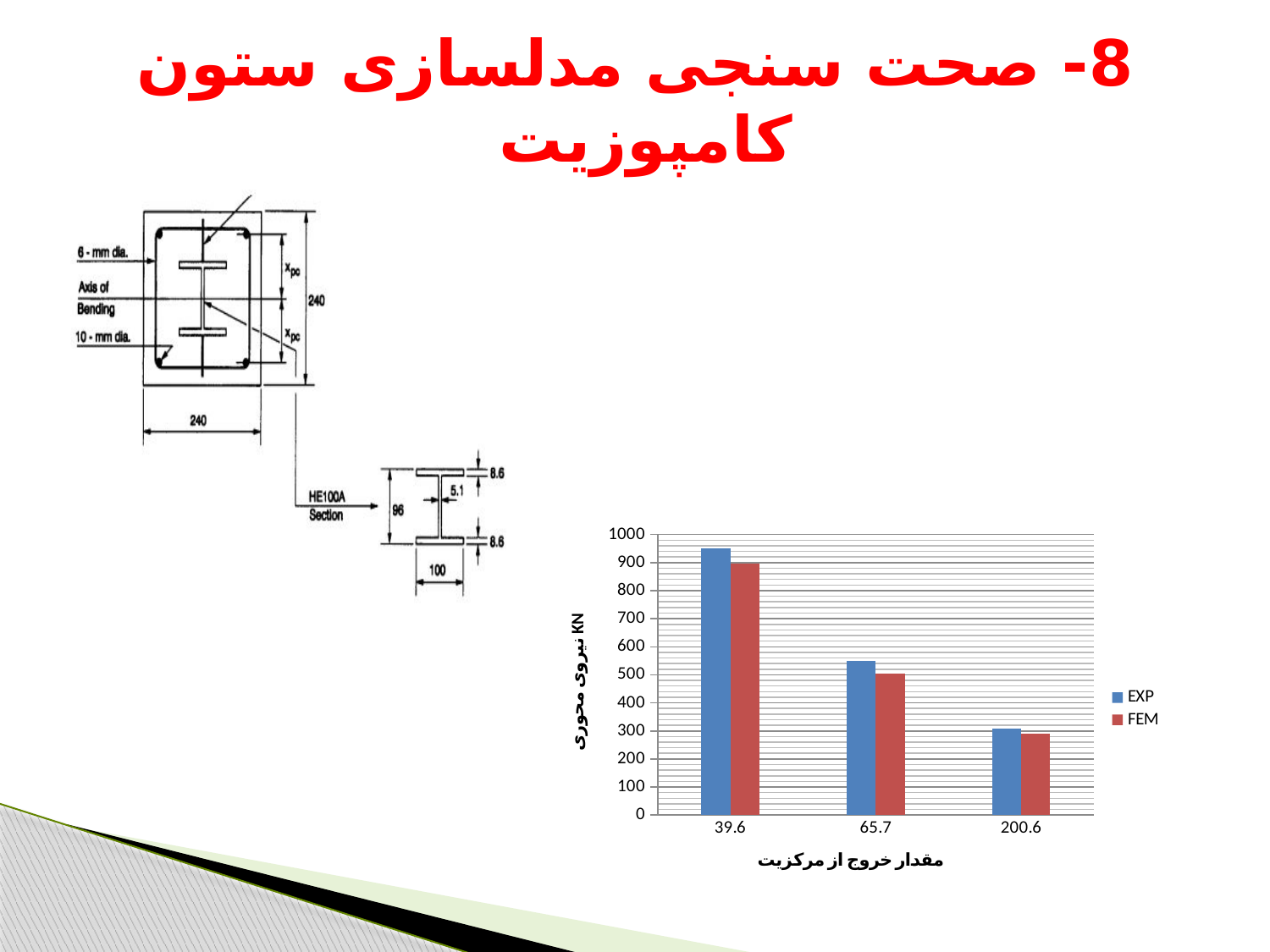
At 39.6, which series has the larger value, EXP or FEM? EXP Do the values rise or fall as you move from 39.6 to 200.6 along the x axis? fall Is the FEM value for 39.6 greater or less than 800? greater Is the EXP value for 39.6 greater or less than 900? greater Which category has the highest EXP value? 39.6 Which category has the lowest values for both series? 200.6 How many series does the chart legend list? 2 What kind of chart is shown on the slide? bar chart How many categories are shown on the x axis of the chart? 3 Is the EXP value for 65.7 greater or less than 500? greater What are the two entries in the chart legend? EXP and FEM